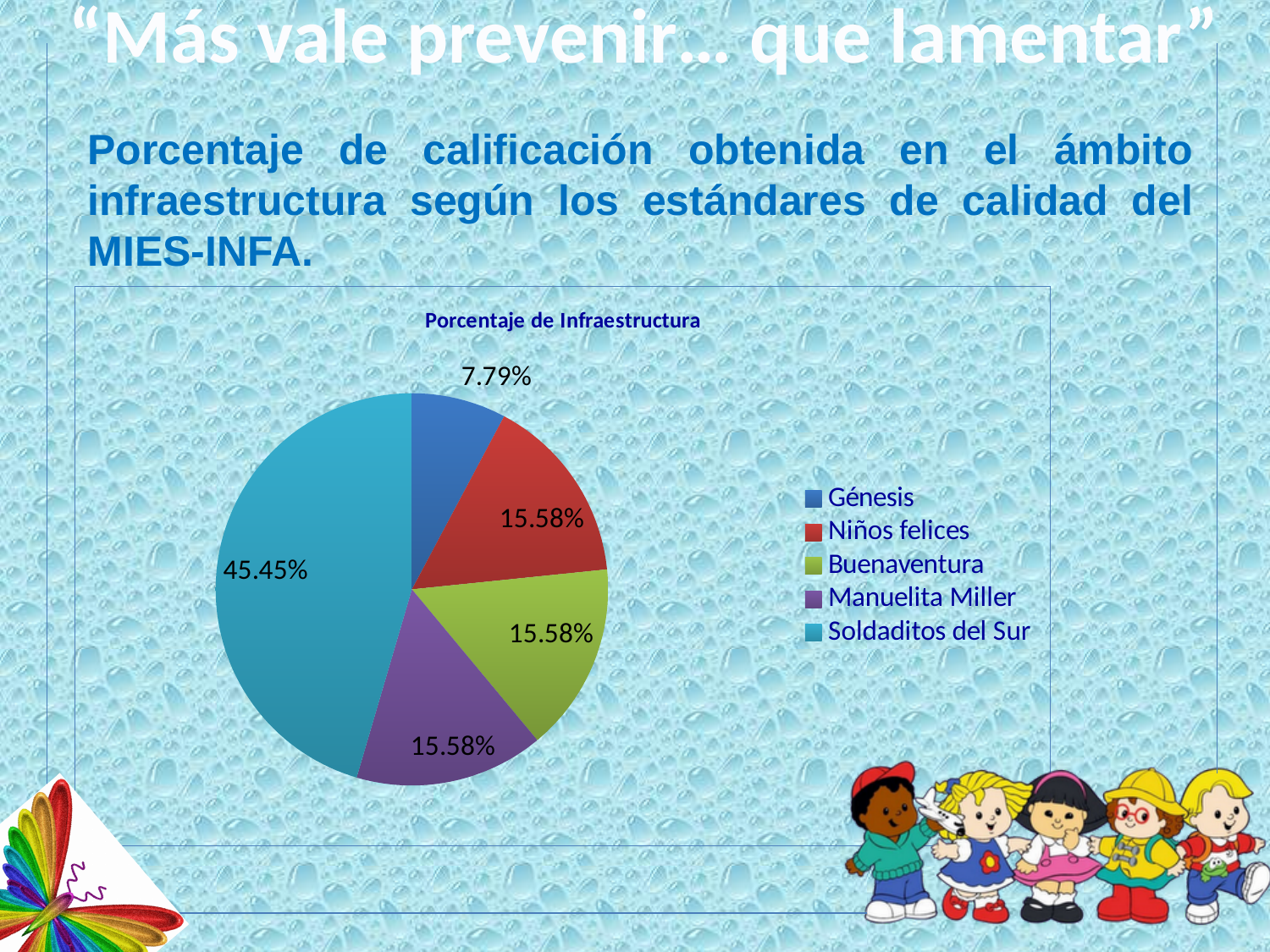
What is the difference between the values for Soldaditos del Sur and Génesis? 37.66% What is the value for Génesis? 7.79% What is the title of the chart? Porcentaje de Infraestructura What is the value for Manuelita Miller? 15.58% Which category has the smallest share of the pie? Génesis What is the value for Soldaditos del Sur? 45.45% How many slices does the pie chart have? 5 What type of chart is shown on the slide? pie chart Which category has the largest share of the pie? Soldaditos del Sur What is the value for Niños felices? 15.58% Which is larger, the value for Buenaventura or the value for Génesis? Buenaventura Which legend entry is shown in red? Niños felices